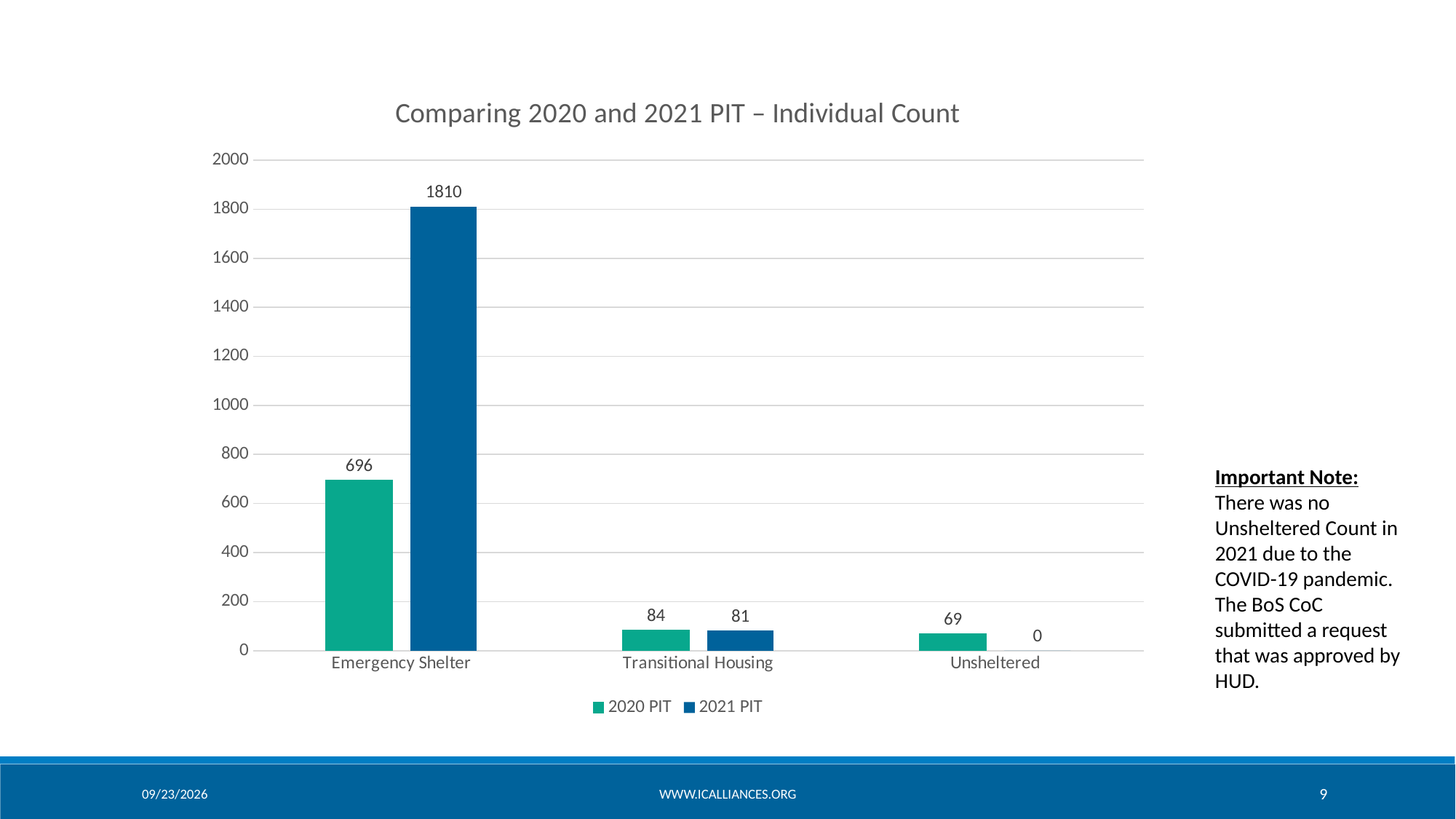
What kind of chart is shown on the slide? Bar chart What is the difference between the 2021 PIT and 2020 PIT values for Emergency Shelter? 1114 What is the 2021 PIT value for Unsheltered? 0 Which category has the highest 2020 PIT value? Emergency Shelter What is the 2021 PIT value for Emergency Shelter? 1810 How many series does the legend list? 2 What is the title of the chart? Comparing 2020 and 2021 PIT – Individual Count Which is larger for Transitional Housing, the 2020 PIT value or the 2021 PIT value? 2020 PIT Which category has the lowest 2021 PIT value? Unsheltered How many categories are shown on the x axis? 3 What is the 2020 PIT value for Transitional Housing? 84 Is the 2020 PIT value for Emergency Shelter greater or less than 600? greater